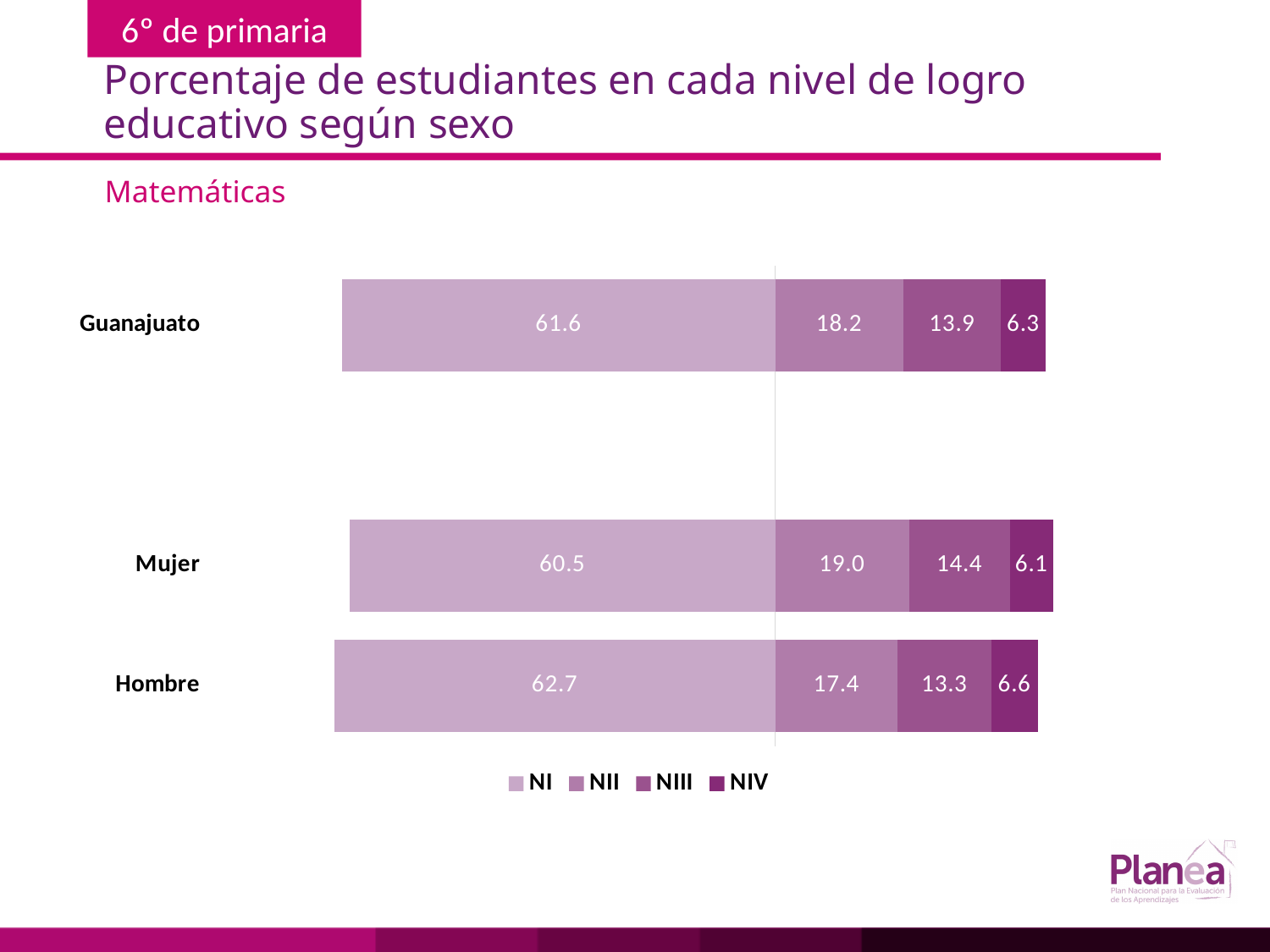
Which is larger, the NII value for Mujer or for Hombre? Mujer How many series does the legend list? 4 What is the NIII value for Mujer? 14.4 What is the NIV value for Hombre? 6.6 What is the NII value for Hombre? 17.4 What kind of chart is shown? Stacked bar chart Which category has the highest NI value? Hombre Which category has the lowest NIV value? Mujer What is the NI value for Guanajuato? 61.6 What is the total of the stacked bar for Guanajuato? 100.0 What is the difference between the NI values for Hombre and Mujer? 2.2 How many categories are shown on the chart? 3